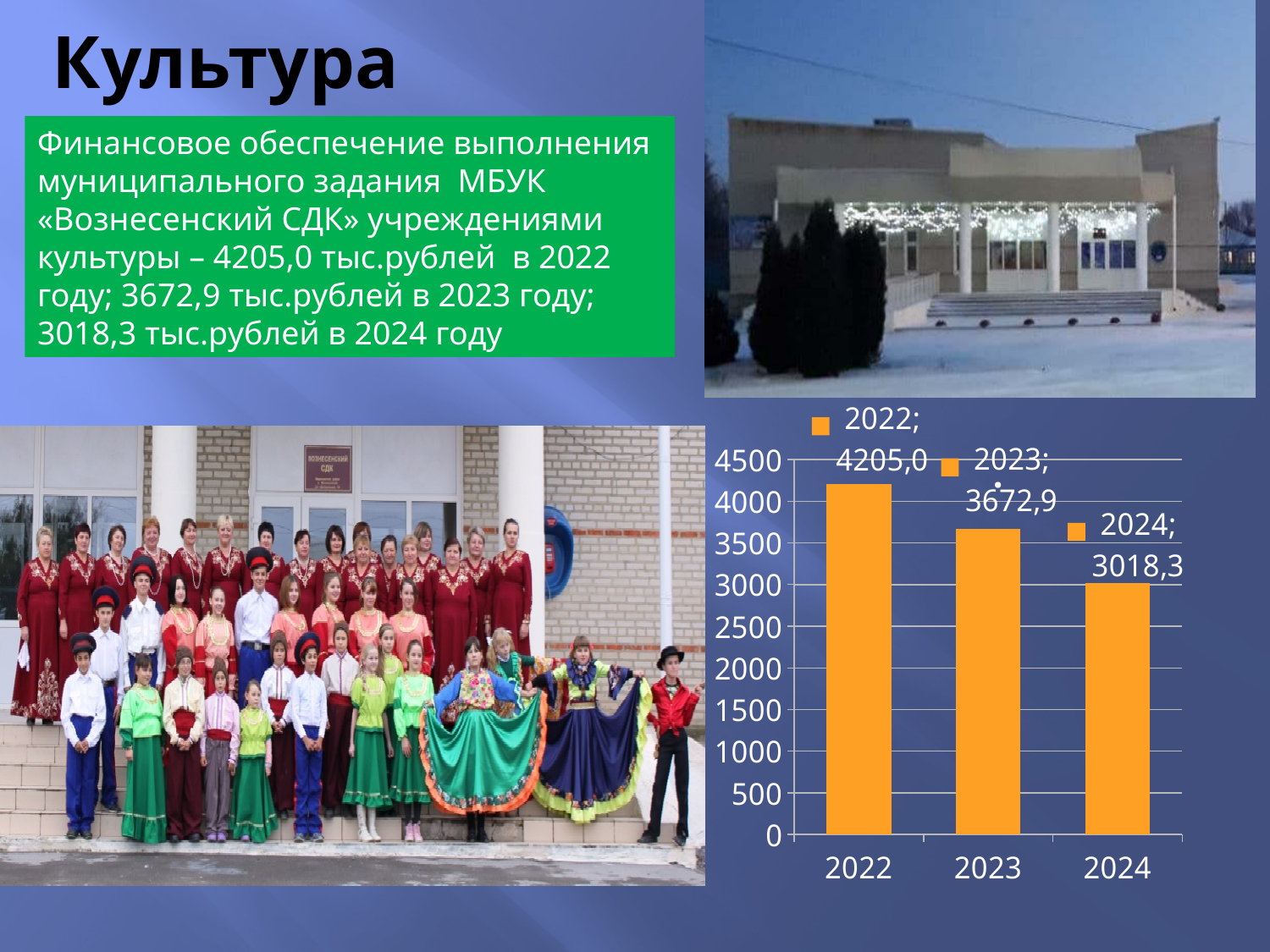
Do the values rise or fall from 2022 to 2024? fall Which is larger, the value for 2023 or the value for 2024? 2023 What is the value for 2024 in the chart? 3018,3 How many bars are plotted in the chart? 3 Which year has the lowest value in the chart? 2024 Is the value for 2024 greater or less than 3500? less What is the difference between the values for 2023 and 2024? 654,6 What is the difference between the values for 2022 and 2023? 532,1 What is the value for 2022 in the chart? 4205,0 Which year has the highest value in the chart? 2022 What type of chart is shown on the slide? bar chart What is the value for 2023 in the chart? 3672,9